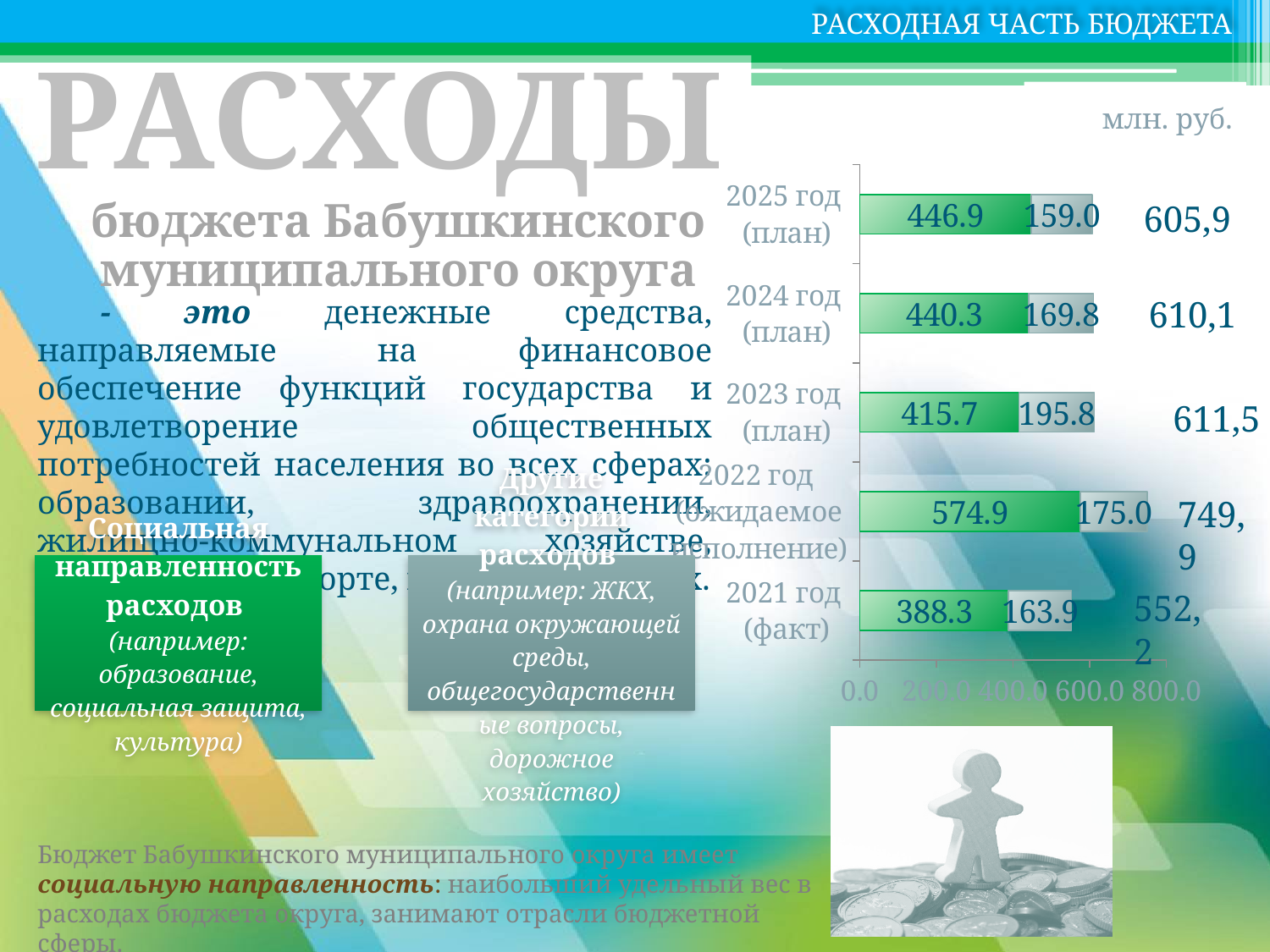
What is the total shown for 2021 год (факт)? 552,2 Which year has the highest value for the green segment (Социальная направленность расходов)? 2022 год (ожидаемое исполнение) What is the value of the grey segment (Другие категории расходов) for 2023 год (план)? 195.8 Is the green segment value for 2022 год (ожидаемое исполнение) larger than the green segment value for 2023 год (план)? Yes How many years (categories) are plotted in the chart? 5 What unit is indicated above the chart? млн. руб. What is the difference between the green segment values for 2025 год (план) and 2024 год (план)? 6.6 Which year has the lowest value for the green segment (Социальная направленность расходов)? 2021 год (факт) Which year has the highest value for the grey segment (Другие категории расходов)? 2023 год (план) What type of chart is shown on the slide? bar chart What is the total shown for 2022 год (ожидаемое исполнение)? 749,9 What is the value of the green segment (Социальная направленность расходов) for 2025 год (план)? 446.9